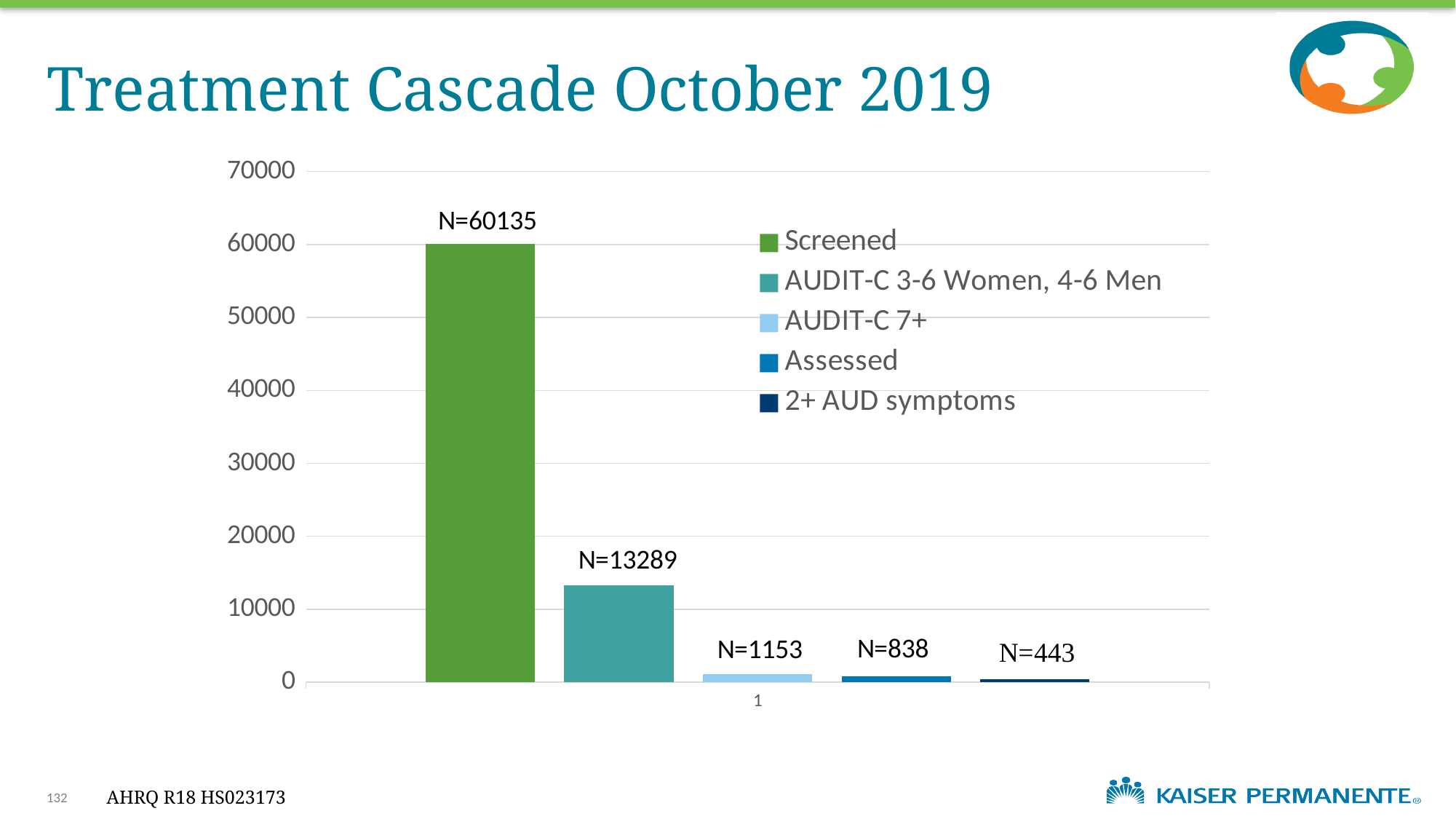
What is the value shown for the Screened bar? N=60135 What is the value shown for the AUDIT-C 3-6 Women, 4-6 Men bar? N=13289 What is the title of the slide containing the chart? Treatment Cascade October 2019 Which is larger, the Assessed value or the 2+ AUD symptoms value? Assessed What is the value shown for the AUDIT-C 7+ bar? N=1153 How many series does the legend list? 5 What is the difference between the Screened value and the AUDIT-C 3-6 Women, 4-6 Men value? 46846 Which series has the lowest value? 2+ AUD symptoms What is the value shown for the 2+ AUD symptoms bar? N=443 Which series has the highest value? Screened What kind of chart is shown on the slide? Bar chart What is the value shown for the Assessed bar? N=838